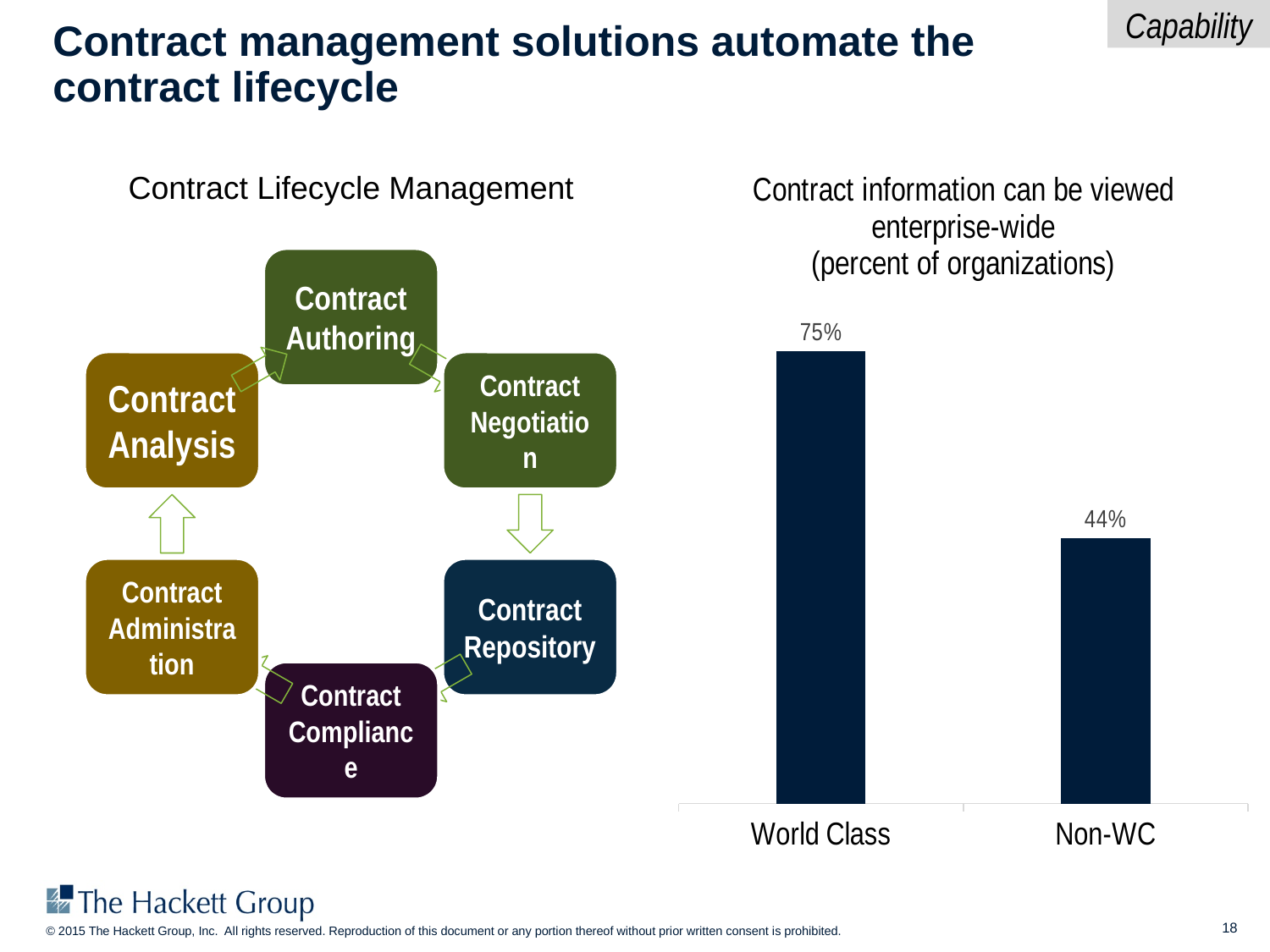
Which category has the highest value in the chart? World Class What is the value for Non-WC in the chart? 44% What is the difference between the World Class and Non-WC values? 31 percentage points What kind of chart is shown on the slide? Bar chart What is the value for World Class in the chart? 75% What is the title of the chart? Contract information can be viewed enterprise-wide (percent of organizations) Which is larger, the value for World Class or the value for Non-WC? World Class What unit are the chart values expressed in, according to the chart title? Percent of organizations How many categories are shown in the chart? 2 Which category has the lowest value in the chart? Non-WC